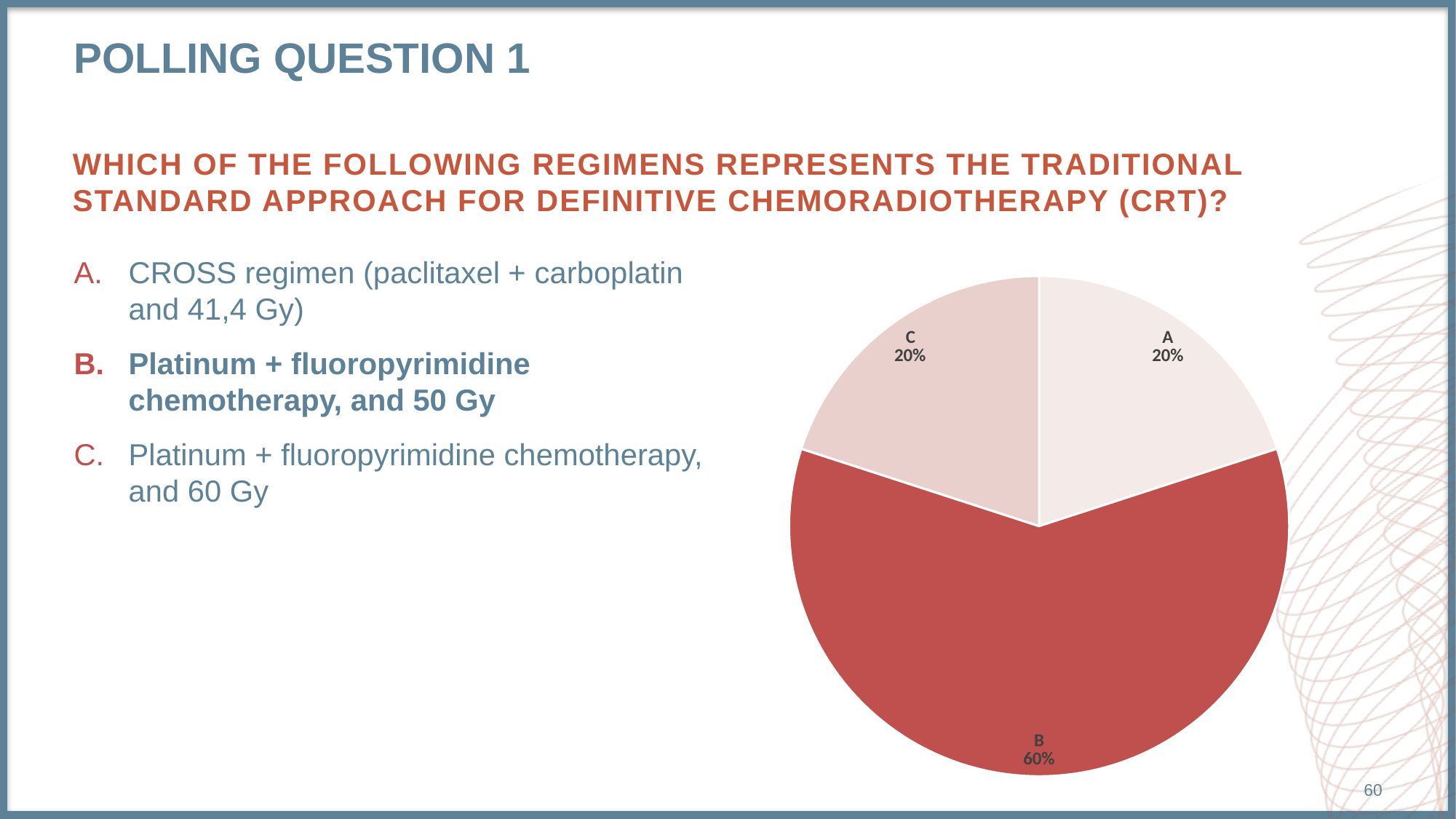
What kind of chart is shown on the slide? Pie chart Which is larger, slice B or slice C? B How many slices does the pie chart have? 3 What percentage of the pie is slice A? 20% Which slice of the pie chart is coloured dark red? B What is the combined share of slices A and C? 40% What is the difference in percentage points between slice B and slice A? 40 Is the share for slice B greater or less than 50%? greater What percentage of the pie is slice C? 20% Which slice of the pie chart is the largest? B What percentage of the pie is slice B? 60%